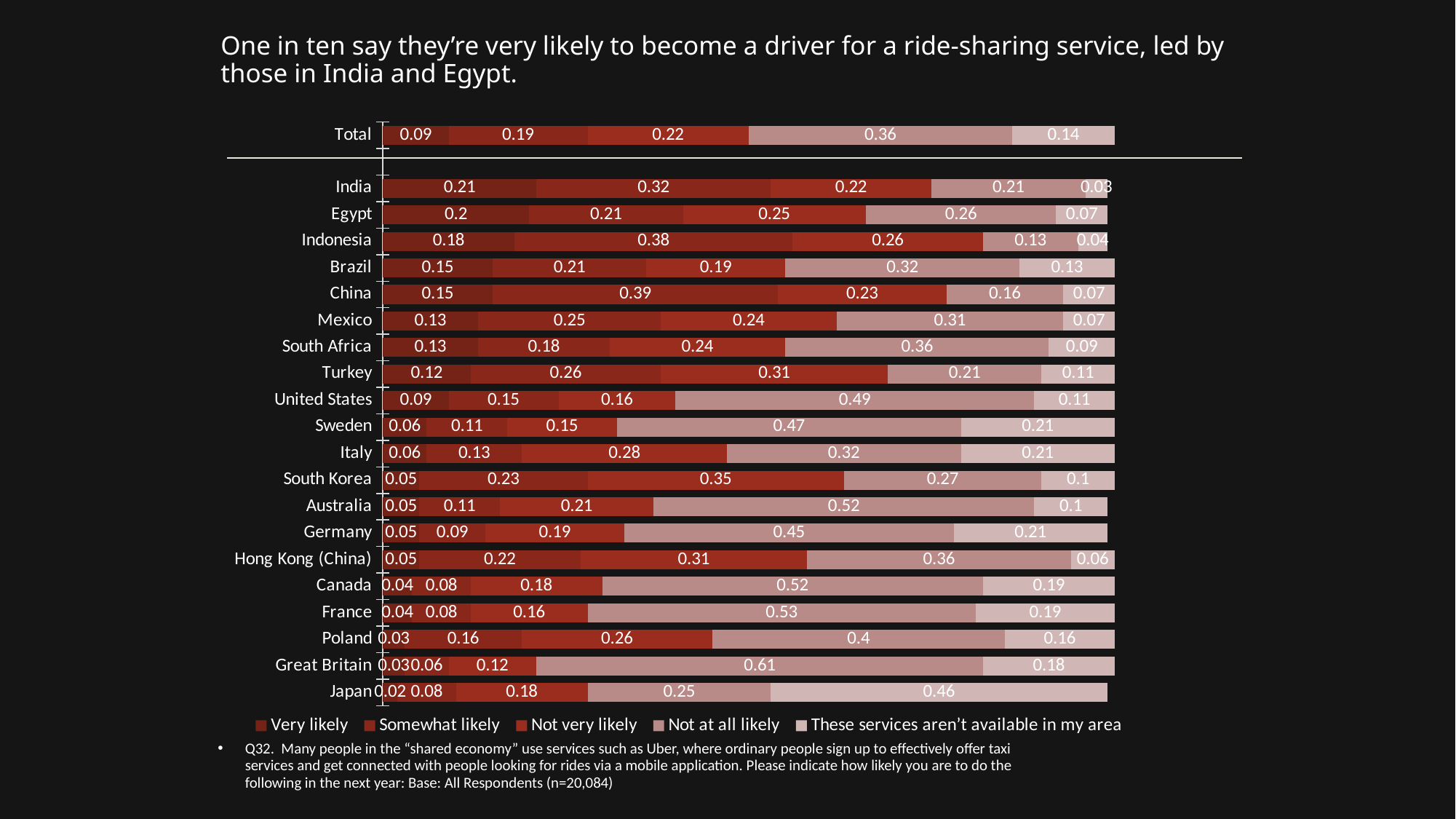
How many series does the legend list? 5 Which has a larger 'Not very likely' value, South Korea or Turkey? South Korea Which country has the highest 'Very likely' value? India What is the difference between the 'Somewhat likely' values for China and Indonesia? 0.01 Which country has the highest 'Not at all likely' value? Great Britain What is the 'Somewhat likely' value for the Total row? 0.19 What is the 'Not at all likely' value for Great Britain? 0.61 Which country has the lowest 'Very likely' value? Japan What is the 'Very likely' value for India? 0.21 What is the 'These services aren't available in my area' value for Japan? 0.46 What kind of chart is shown on the slide? Stacked bar chart How many rows (including Total) are plotted in the chart? 21